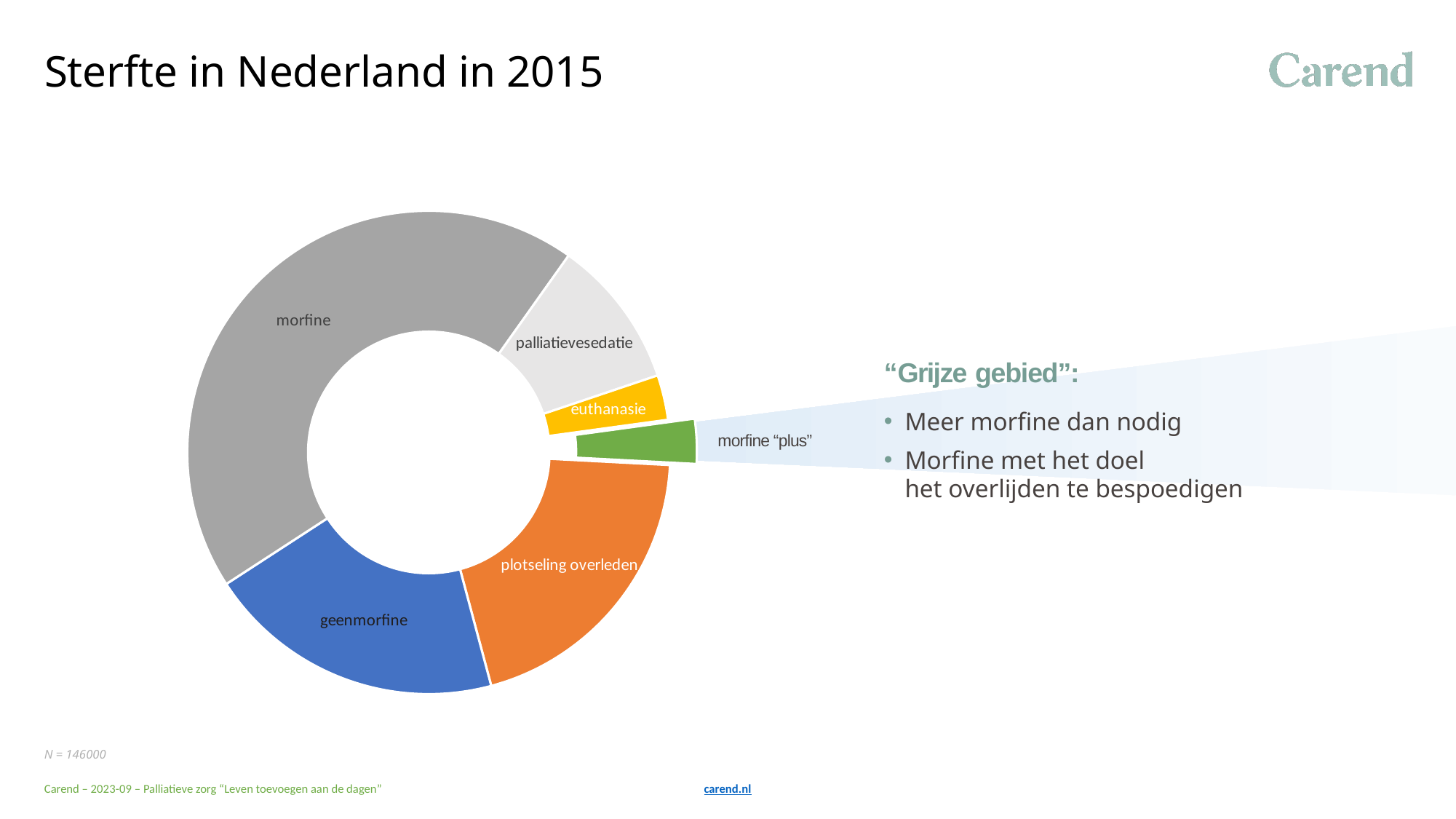
Which slice is larger, plotseling overleden or palliatievesedatie? plotseling overleden Which category has the largest slice in the chart? morfine What kind of chart is shown on the slide? doughnut (pie) chart Which slice is larger, palliatievesedatie or euthanasie? palliatievesedatie What is the title of the slide containing the chart? Sterfte in Nederland in 2015 How many slices does the chart have? 6 Which slice is pulled out from the rest of the chart and linked to the "Grijze gebied" text? morfine "plus" Which slice is larger, morfine or plotseling overleden? morfine